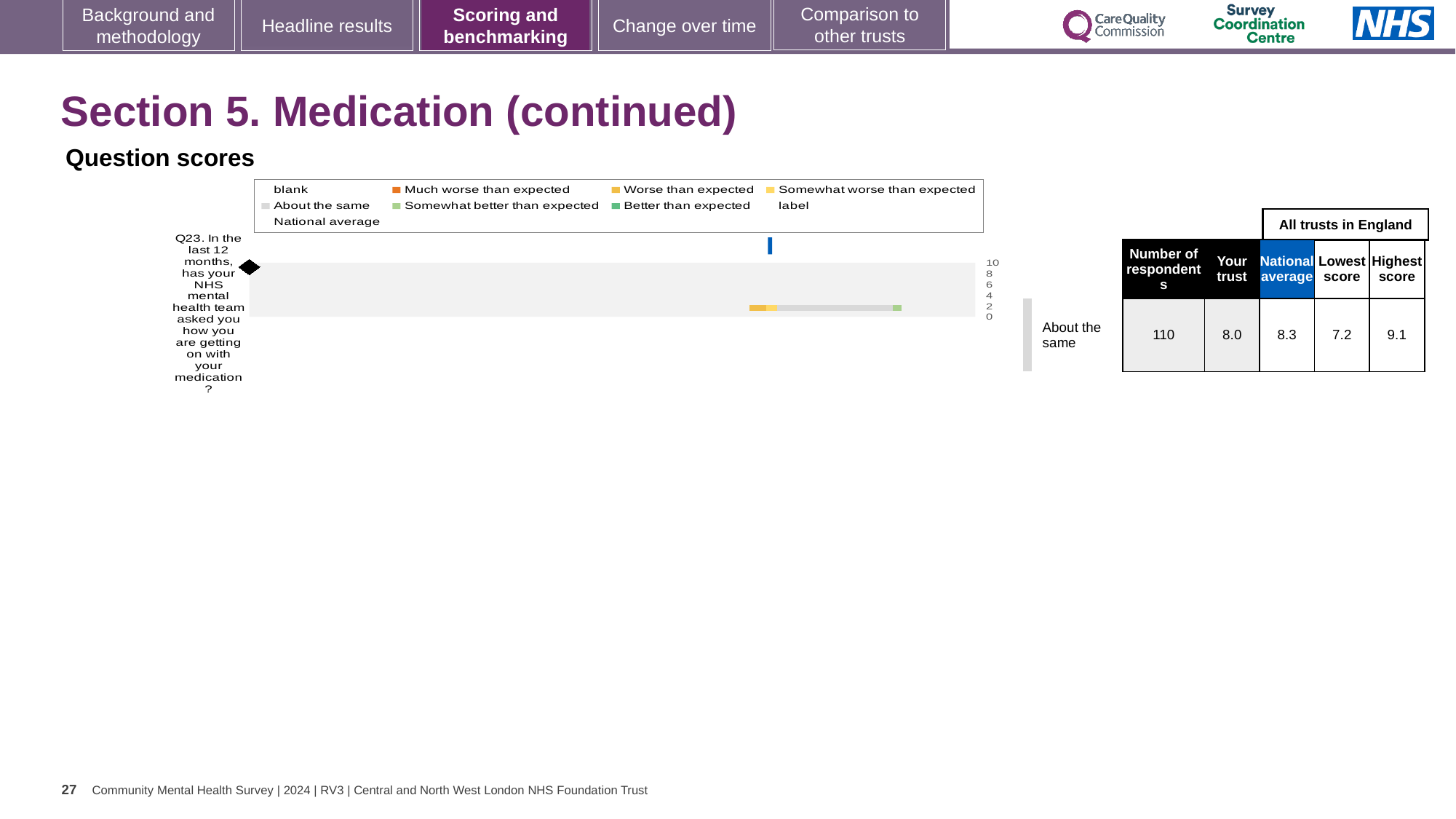
In the table beside the chart, what is the national average score for Q23? 8.3 In the table beside the chart, what is the number of respondents for Q23? 110 What is the difference between the national average score and the 'Your trust' score for Q23? 0.3 In the table beside the chart, what is the highest score among all trusts in England for Q23? 9.1 Which question number is plotted in the chart? Q23 How many survey questions are plotted in the chart? 1 Which is larger for Q23: the 'Your trust' score or the national average score? National average What benchmarking category is the trust's Q23 score assigned to, as labelled next to the chart? About the same In the table beside the chart, what is the 'Your trust' score for Q23? 8.0 What kind of chart is shown under 'Question scores'? bar chart What is the highest tick value shown on the chart's axis? 10 In the table beside the chart, what is the lowest score among all trusts in England for Q23? 7.2